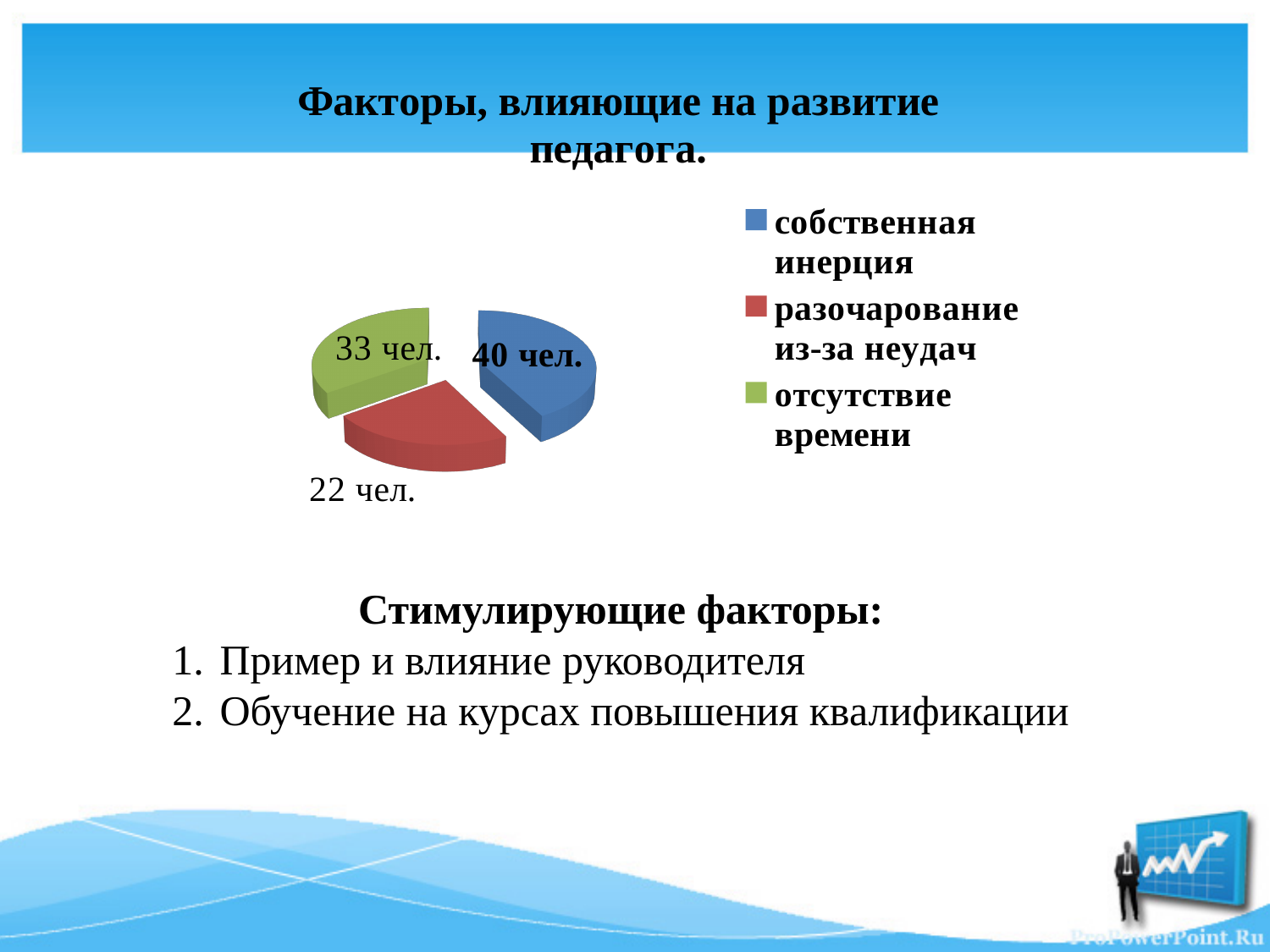
What colour is the slice for "отсутствие времени"? green What is the difference between the values for "отсутствие времени" and "разочарование из-за неудач"? 11 чел. What kind of chart is shown on the slide? pie chart Which factor has the largest slice in the pie chart? собственная инерция How many entries does the legend list? 3 What value is shown for the slice "собственная инерция"? 40 чел. Which factor has the smallest slice in the pie chart? разочарование из-за неудач What is the difference between the values for "собственная инерция" and "разочарование из-за неудач"? 18 чел. Which is larger: the value for "отсутствие времени" or the value for "собственная инерция"? собственная инерция What value is shown for the slice "отсутствие времени"? 33 чел. What value is shown for the slice "разочарование из-за неудач"? 22 чел. How many slices does the pie chart have? 3